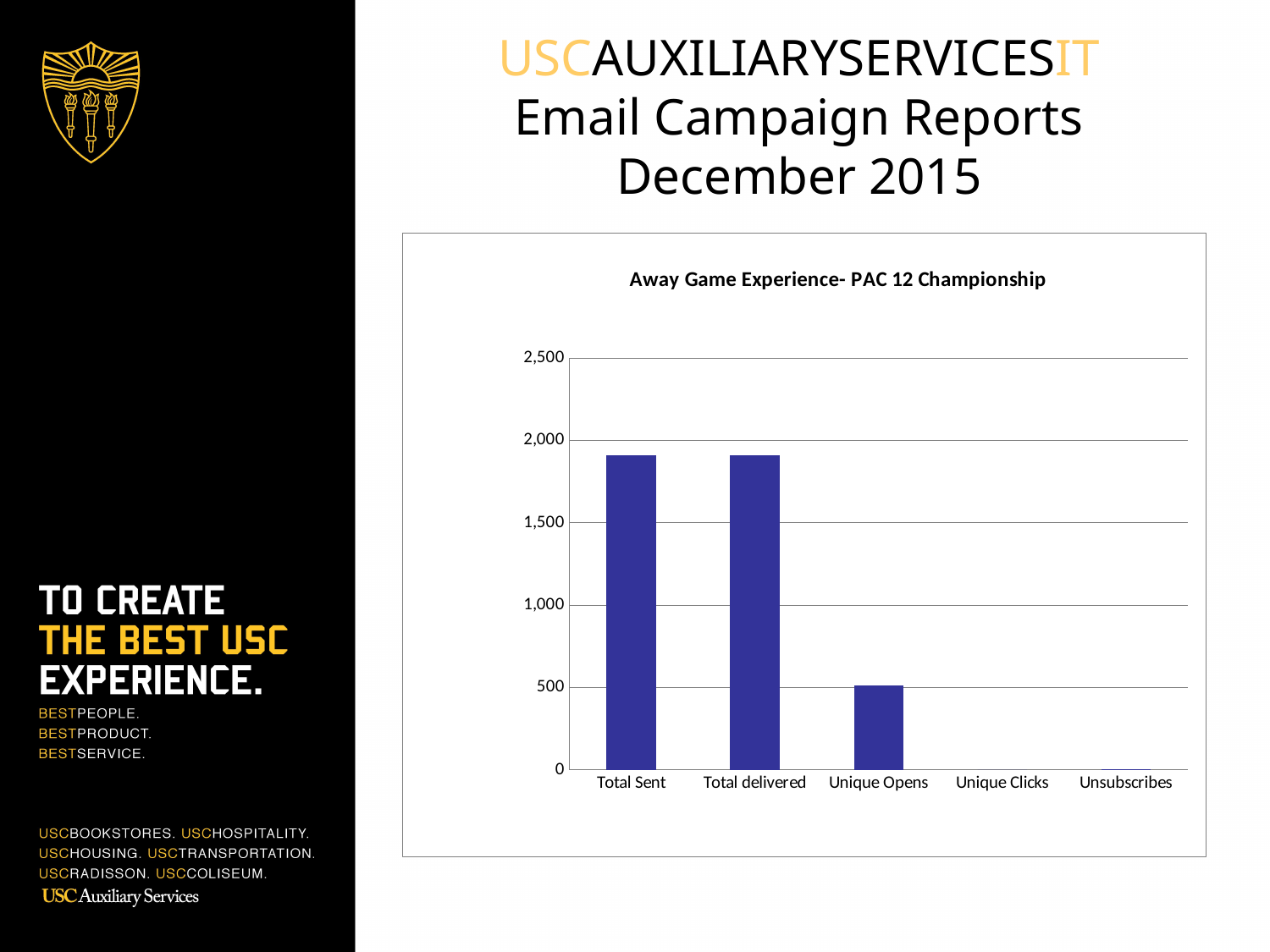
Do the values generally rise or fall moving from left to right along the x axis? fall What kind of chart is shown on the slide? bar chart Is the value for Unique Opens greater or less than 1,000? less Is the value for Unique Clicks greater or less than 500? less Which is larger, the value for Total Sent or the value for Unique Opens? Total Sent Is the value for Total delivered greater or less than 2,000? less What is the title of the chart? Away Game Experience- PAC 12 Championship How many categories are shown on the x axis of the chart? 5 What is the highest value shown on the vertical axis of the chart? 2,500 Which is larger, the value for Unique Opens or the value for Unsubscribes? Unique Opens